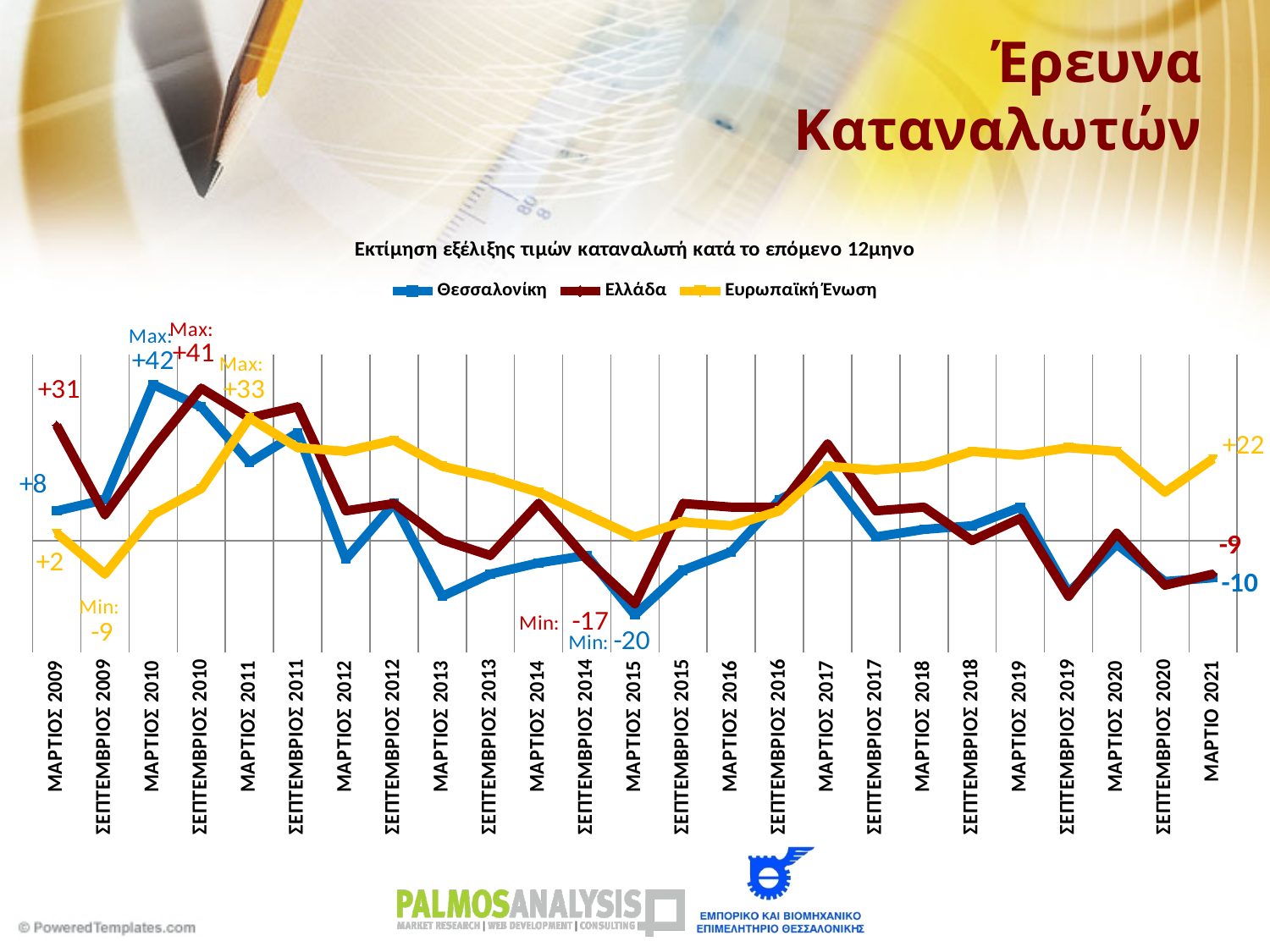
How many time points are shown on the x axis? 25 What is the minimum value reached by the Ελλάδα series? -17 What is the minimum value reached by the Ευρωπαϊκή Ένωση series? -9 What is the title of the chart? Εκτίμηση εξέλιξης τιμών καταναλωτή κατά το επόμενο 12μηνο What is the value for Θεσσαλονίκη in ΜΑΡΤΙΟΣ 2009? +8 In ΜΑΡΤΙΟ 2021, which is larger: the value for Ευρωπαϊκή Ένωση or the value for Θεσσαλονίκη? Ευρωπαϊκή Ένωση What is the difference between the maximum of Θεσσαλονίκη (+42) and the maximum of Ελλάδα (+41)? 1 What kind of chart is shown on the slide? line chart What is the value for Ευρωπαϊκή Ένωση in ΜΑΡΤΙΟ 2021? +22 How many series does the legend list? 3 What is the value for Ελλάδα in ΜΑΡΤΙΟΣ 2009? +31 What is the maximum value reached by the Θεσσαλονίκη series? +42